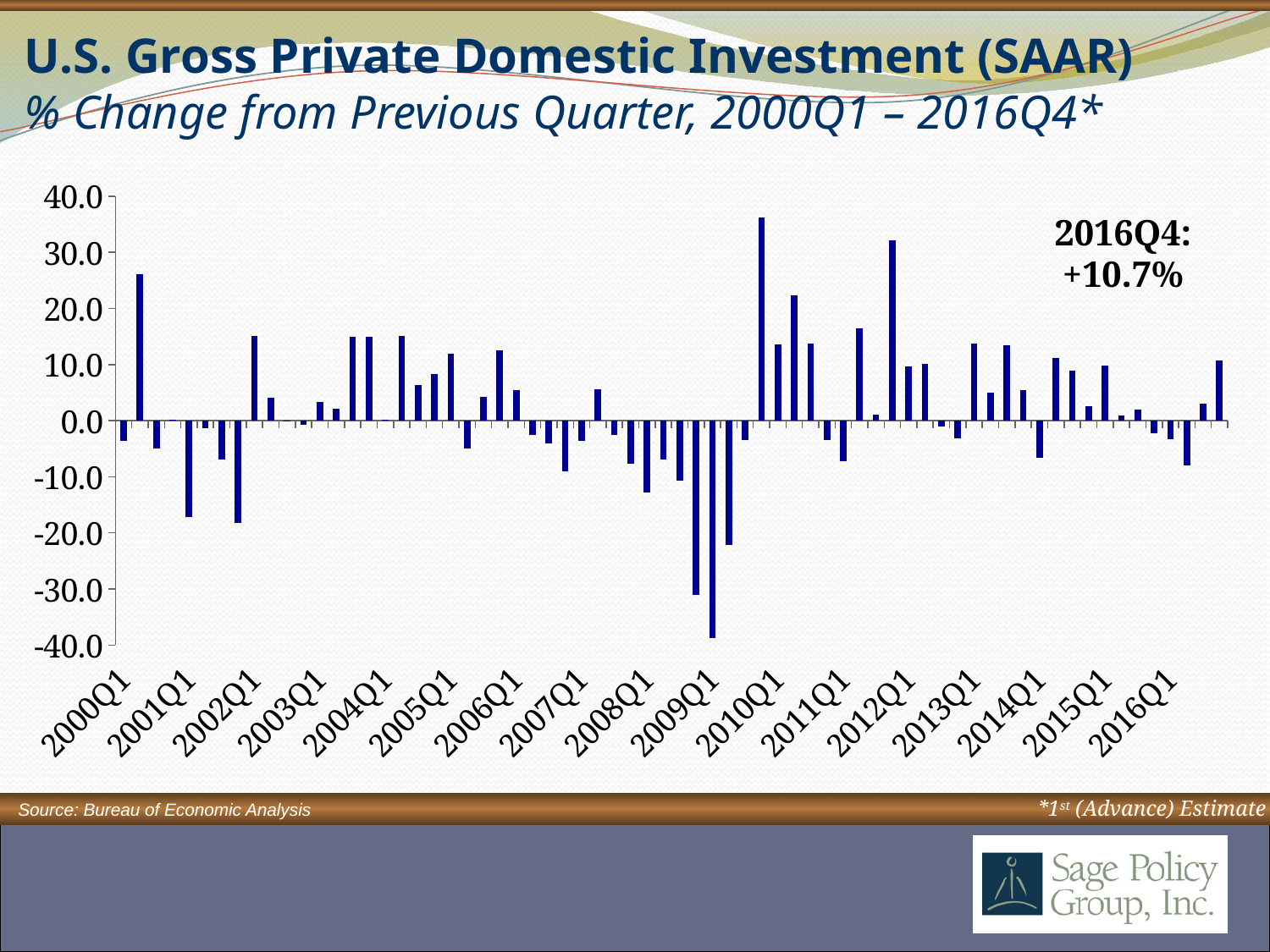
Is the value for 2001Q1 greater or less than -10? less Is the value for 2016Q1 greater or less than 0? less Is the lowest bar on the chart greater or less than -30? less What is the value for 2016Q4? +10.7% What is the title of the chart? U.S. Gross Private Domestic Investment (SAAR) What is the highest value shown on the y axis? 40.0 What kind of chart is shown on the slide? bar chart